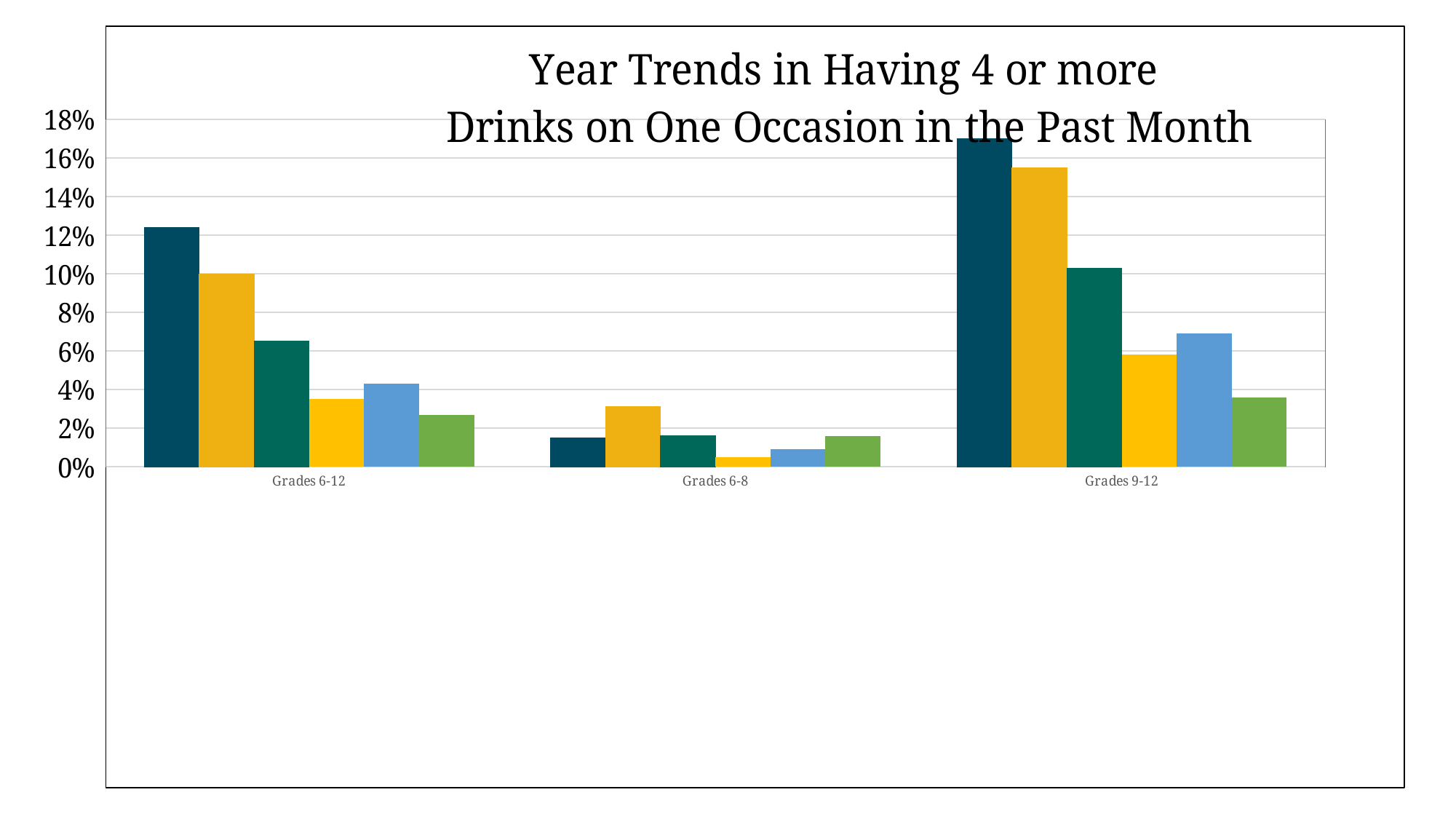
Is the first (dark navy) bar for Grades 9-12 greater or less than 14%? greater How many grade-group categories are shown on the x axis? 3 Is the first (dark navy) bar for Grades 6-12 greater or less than 10%? greater Is the first (dark navy) bar for Grades 6-8 greater or less than 2%? less What kind of chart is shown on the slide? Bar chart How many bars are plotted for each grade-group category? 6 Which is larger: the first (dark navy) bar for Grades 9-12 or the first (dark navy) bar for Grades 6-12? Grades 9-12 What is the highest value shown on the vertical axis? 18% Which grade-group category has the lowest bars overall? Grades 6-8 Which grade-group category contains the tallest bar in the chart? Grades 9-12 What is the title of the chart? Year Trends in Having 4 or more Drinks on One Occasion in the Past Month